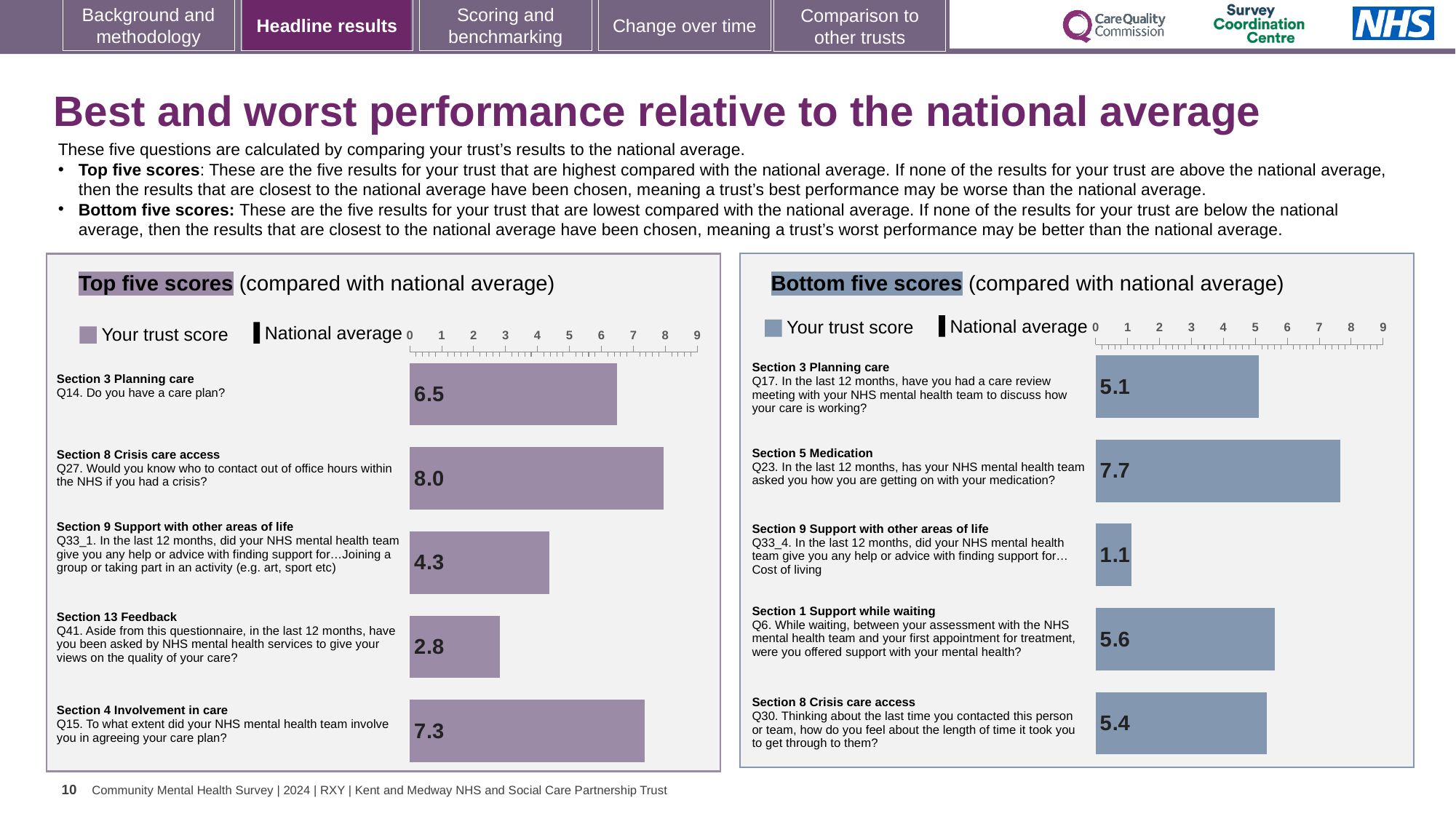
What type of chart is the Bottom five scores chart? Bar chart In the Top five scores chart, what is the trust score for Q27 (Section 8 Crisis care access)? 8.0 In the Bottom five scores chart, which question has the highest trust score? Q23 (Section 5 Medication) In the Top five scores chart, what is the difference between the trust scores for Q15 and Q41? 4.5 In the Bottom five scores chart, what is the trust score for Q23 (Section 5 Medication)? 7.7 In the Top five scores chart, what is the trust score for Q33_1 (Section 9 Support with other areas of life)? 4.3 In the Top five scores chart, is the trust score for Q14 greater or less than 6? greater In the Bottom five scores chart, what is the difference between the trust scores for Q23 and Q17? 2.6 In the Bottom five scores chart, which question has the lowest trust score? Q33_4 (Section 9 Support with other areas of life, Cost of living) In the Top five scores chart, which question has the highest trust score? Q27 (Section 8 Crisis care access) How many bars are shown in the Top five scores chart? 5 In the Bottom five scores chart, which has the larger trust score, Q6 or Q30? Q6